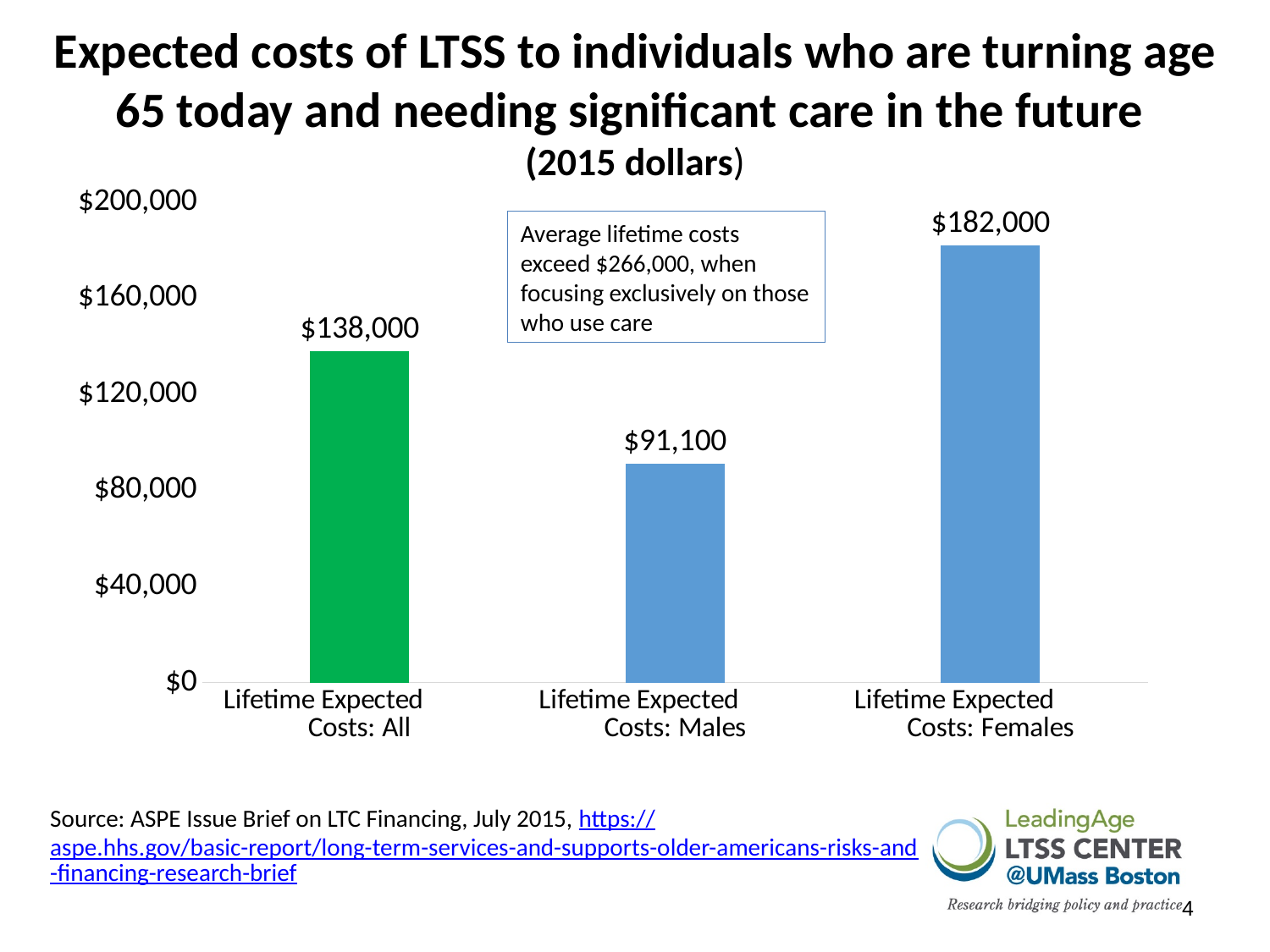
What is the value for Lifetime Expected Costs: Females? $182,000 What kind of chart is shown on the slide? bar chart Is the value for Lifetime Expected Costs: Females greater or less than $160,000? greater What is the value for Lifetime Expected Costs: Males? $91,100 What colour is the bar for Lifetime Expected Costs: All? green Which is larger, the value for Lifetime Expected Costs: All or the value for Lifetime Expected Costs: Males? Lifetime Expected Costs: All How many categories are shown in the chart? 3 What is the value for Lifetime Expected Costs: All? $138,000 Which category has the lowest value? Lifetime Expected Costs: Males Which category has the highest value? Lifetime Expected Costs: Females What is the difference between the value for Lifetime Expected Costs: All and the value for Lifetime Expected Costs: Males? $46,900 What is the difference between the value for Lifetime Expected Costs: Females and the value for Lifetime Expected Costs: Males? $90,900